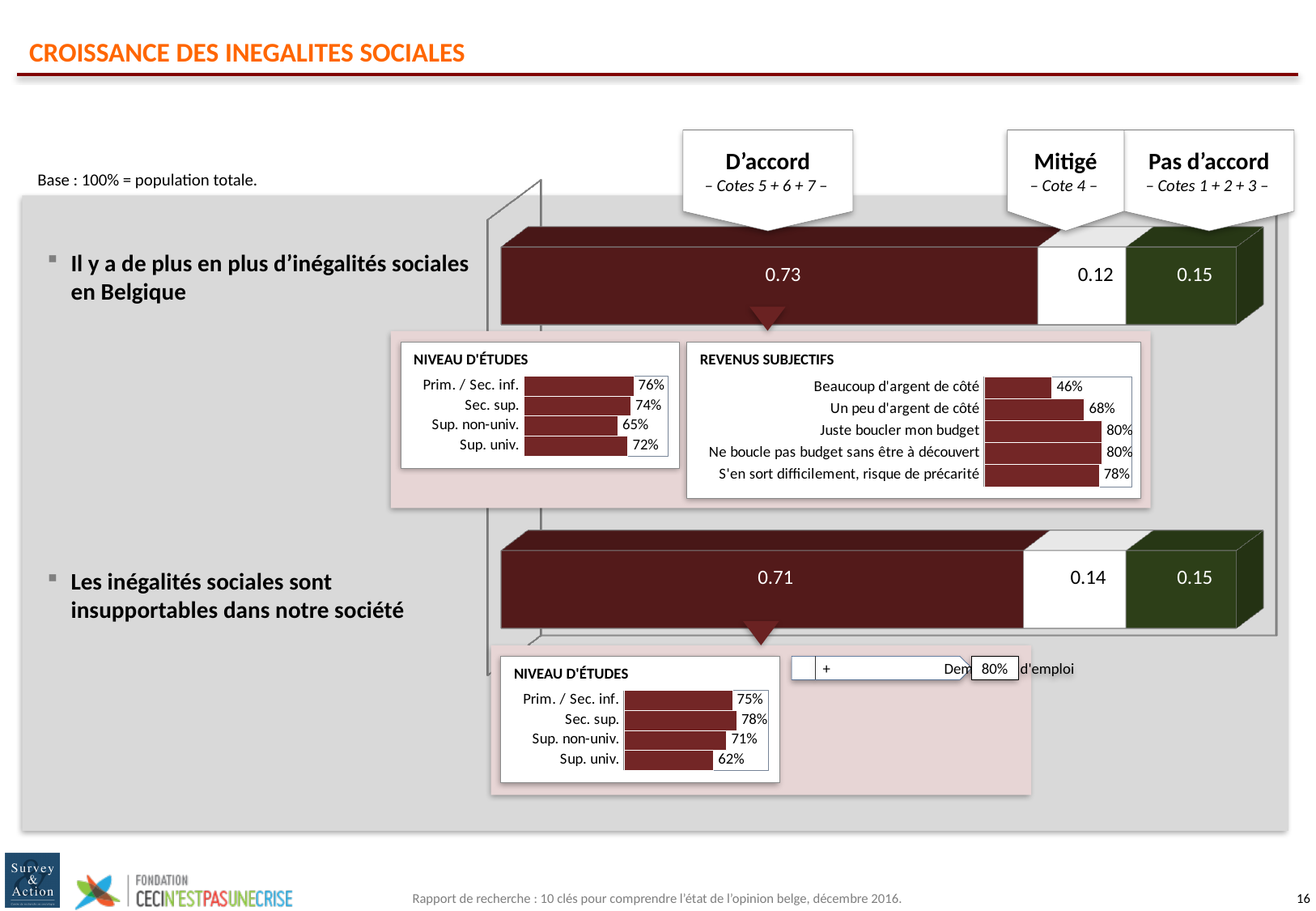
In the 'REVENUS SUBJECTIFS' chart, what is the value for 'Beaucoup d'argent de côté'? 46% In the 'NIVEAU D'ÉTUDES' chart under the first statement (de plus en plus d'inégalités), which category has the highest value? Prim. / Sec. inf. In the 'NIVEAU D'ÉTUDES' chart under the second statement (inégalités insupportables), which is larger: 'Sec. sup.' or 'Sup. non-univ.'? Sec. sup. In the stacked bar for 'Il y a de plus en plus d'inégalités sociales en Belgique', what is the total of the three segments? 1.00 In the stacked bar for 'Il y a de plus en plus d'inégalités sociales en Belgique', what is the value for 'D'accord'? 0.73 In the 'NIVEAU D'ÉTUDES' chart under the second statement (inégalités insupportables), what is the value for 'Sup. univ.'? 62% How many categories are shown in the 'REVENUS SUBJECTIFS' chart? 5 What kind of chart is the 'REVENUS SUBJECTIFS' chart? Bar chart In the stacked bar for 'Les inégalités sociales sont insupportables dans notre société', what is the difference between 'D'accord' and 'Pas d'accord'? 0.56 In the stacked bar for 'Les inégalités sociales sont insupportables dans notre société', what is the value for 'Mitigé'? 0.14 In the 'REVENUS SUBJECTIFS' chart, which category has the lowest value? Beaucoup d'argent de côté In the 'NIVEAU D'ÉTUDES' chart under the first statement (de plus en plus d'inégalités), what is the value for 'Sup. non-univ.'? 65%